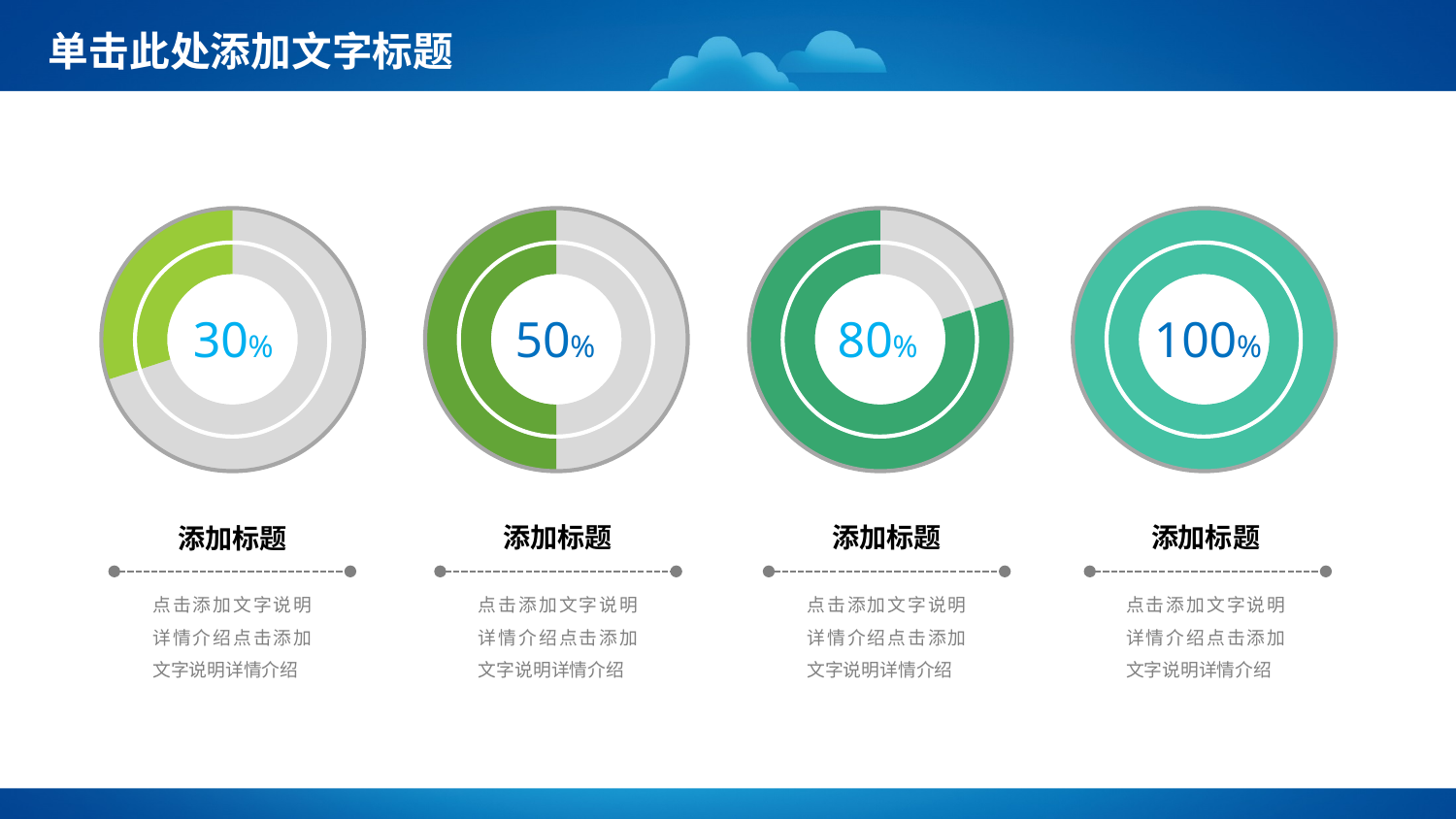
What value is shown in the second donut chart from the left? 50% Which is larger, the value in the second donut chart or the value in the third donut chart? The third donut chart (80%) Do the percentage values rise or fall from the leftmost chart to the rightmost chart? Rise What value is shown in the rightmost donut chart? 100% How many donut charts are on the slide? 4 What value is shown in the leftmost donut chart? 30% Which donut chart shows the lowest percentage? The leftmost one (30%) What is the difference between the value in the rightmost donut chart and the value in the second donut chart? 50% What value is shown in the third donut chart from the left? 80% Which donut chart shows the highest percentage? The rightmost one (100%) What kind of chart is used to display the percentages on this slide? Donut chart What is the difference between the value in the third donut chart and the value in the leftmost donut chart? 50%